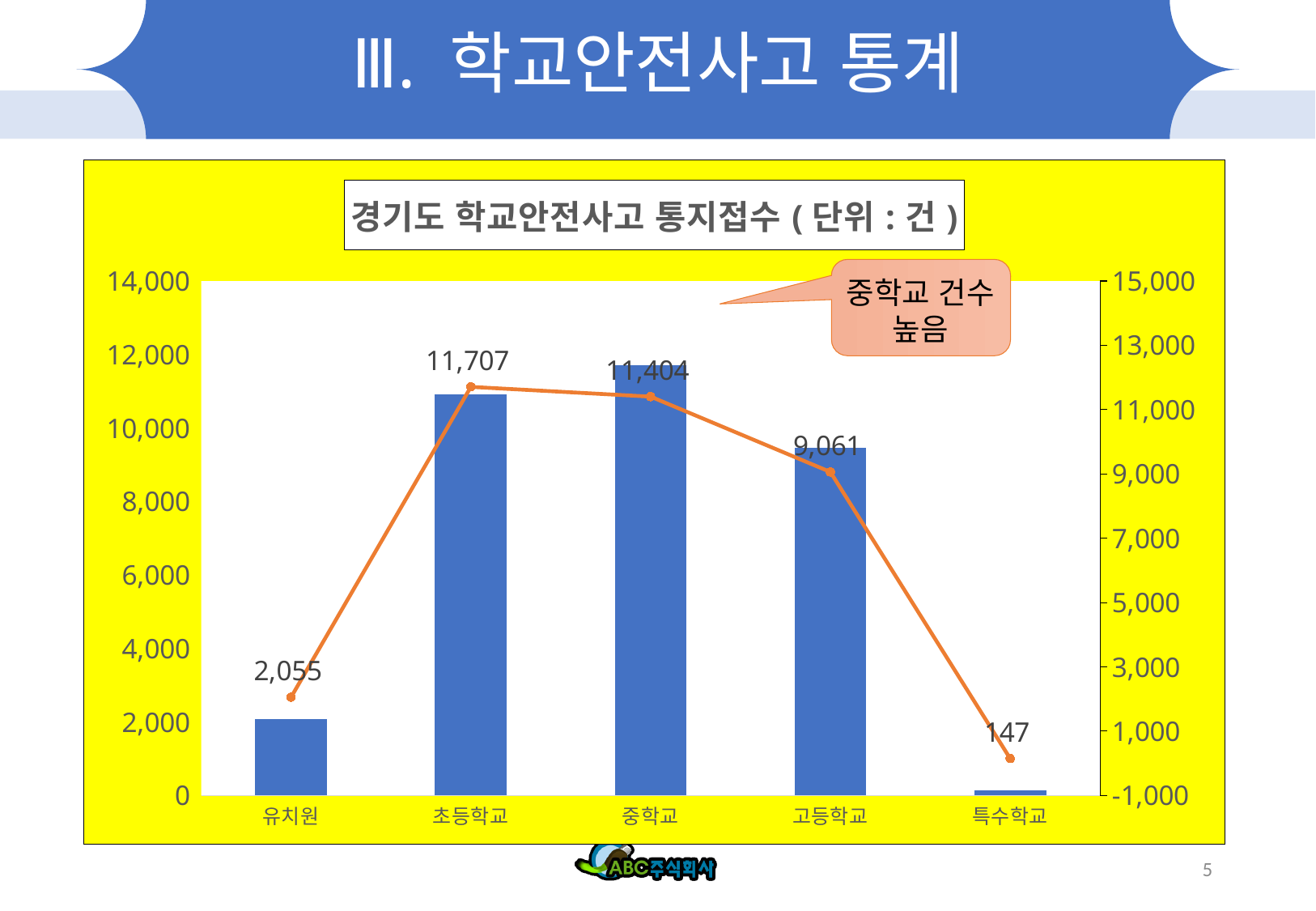
Which is larger, the labeled value for 고등학교 or for 유치원? 고등학교 What is the difference between the labeled values for 초등학교 and 중학교? 303 What is the data label shown for 특수학교? 147 What is the difference between the labeled values for 유치원 and 특수학교? 1,908 What is the title of the chart? 경기도 학교안전사고 통지접수 ( 단위 : 건 ) What is the data label shown for 중학교? 11,404 What is the data label shown for 초등학교? 11,707 What is the data label shown for 유치원? 2,055 How many categories are shown on the x axis? 5 What kind of chart is this? Bar chart with a line overlay Which category has the lowest value? 특수학교 What is the data label shown for 고등학교? 9,061